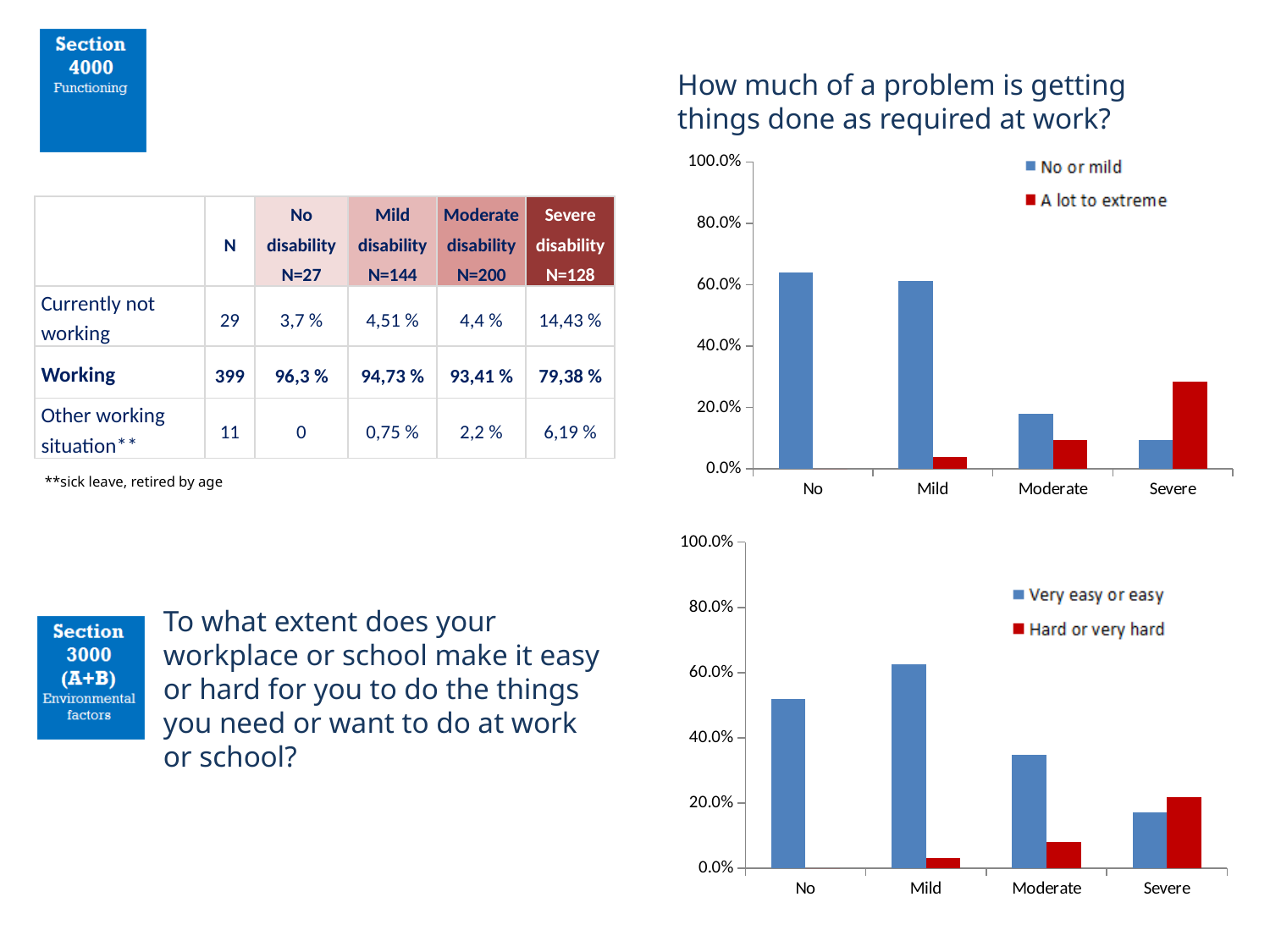
In the bottom chart, is the "Hard or very hard" value for the Severe category greater or less than 40.0%? less In the top chart ("How much of a problem is getting things done as required at work?"), which category has the highest value for "A lot to extreme"? Severe In the top chart ("How much of a problem is getting things done as required at work?"), for the Moderate category, which series has the larger value: "No or mild" or "A lot to extreme"? No or mild What kind of chart is the top chart titled "How much of a problem is getting things done as required at work?"? Bar chart In the top chart ("How much of a problem is getting things done as required at work?"), how many categories are shown on the x axis? 4 In the top chart ("How much of a problem is getting things done as required at work?"), how many series does the legend list? 2 In the bottom chart, which category has the highest value for "Very easy or easy"? Mild In the top chart ("How much of a problem is getting things done as required at work?"), is the "No or mild" value for the No category greater or less than 40.0%? greater What are the two legend entries of the bottom chart? Very easy or easy; Hard or very hard In the top chart ("How much of a problem is getting things done as required at work?"), do the "No or mild" values rise or fall from No to Severe? Fall In the bottom chart, how many series does the legend list? 2 In the bottom chart, which category has the lowest value for "Very easy or easy"? Severe